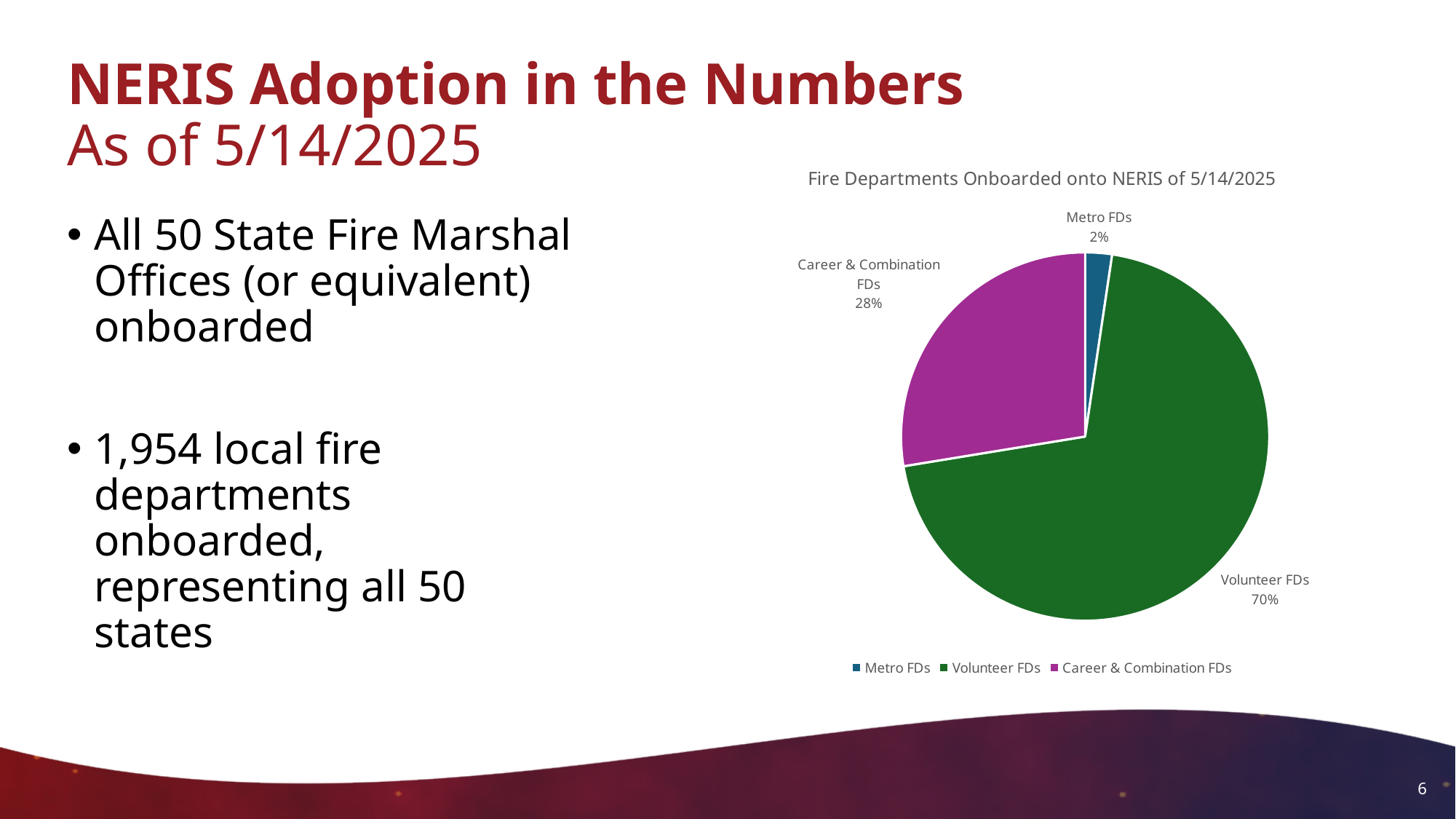
How many entries does the legend list? 3 How many categories are shown in the pie chart? 3 What is the title of the chart? Fire Departments Onboarded onto NERIS of 5/14/2025 What colour is the Volunteer FDs slice? green Which category has the largest slice of the pie? Volunteer FDs What share of the pie do Metro FDs represent? 2% What share of the pie do Career & Combination FDs represent? 28% What share of the pie do Volunteer FDs represent? 70% What kind of chart is shown on the slide? pie chart Which is larger, the share for Career & Combination FDs or the share for Metro FDs? Career & Combination FDs Which category has the smallest slice of the pie? Metro FDs What is the difference in percentage points between Volunteer FDs and Career & Combination FDs? 42